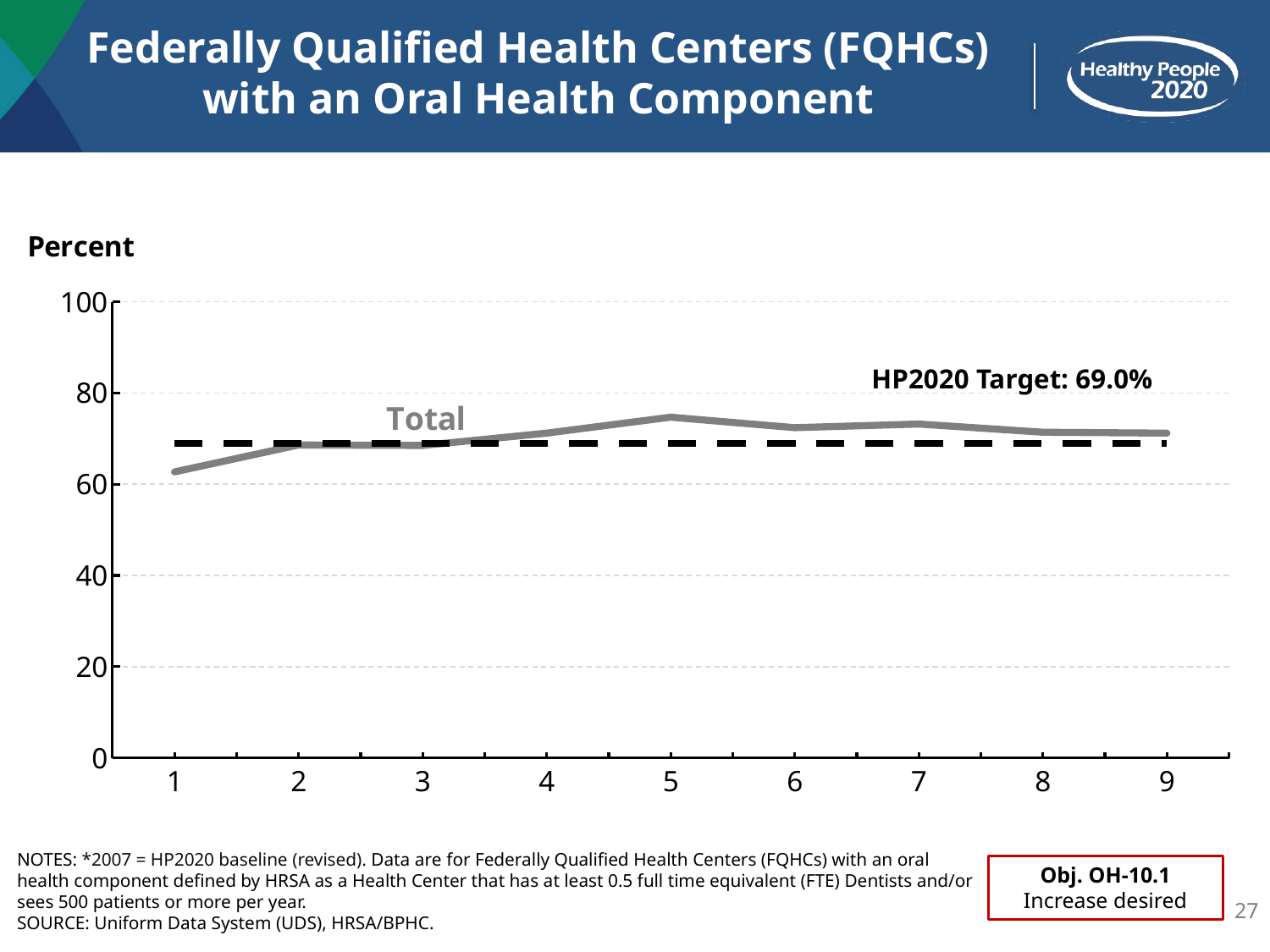
What is the label on the y axis of the chart? Percent At which x-axis point is the Total line lowest? 1 Is the value of the Total line at point 5 greater or less than 60? greater Is the value of the Total line at point 1 greater or less than 80? less Which is larger, the Total value at point 1 or at point 5? point 5 Does the Total line rise or fall from point 1 to point 5? rise What kind of chart is shown on the slide? line chart What is the label of the plotted line on the chart? Total At which x-axis point does the Total line reach its highest value? 5 Is the value of the Total line at point 9 greater or less than 40? greater What is the HP2020 Target value shown on the chart? 69.0% How many data points are plotted along the x axis of the Total line? 9